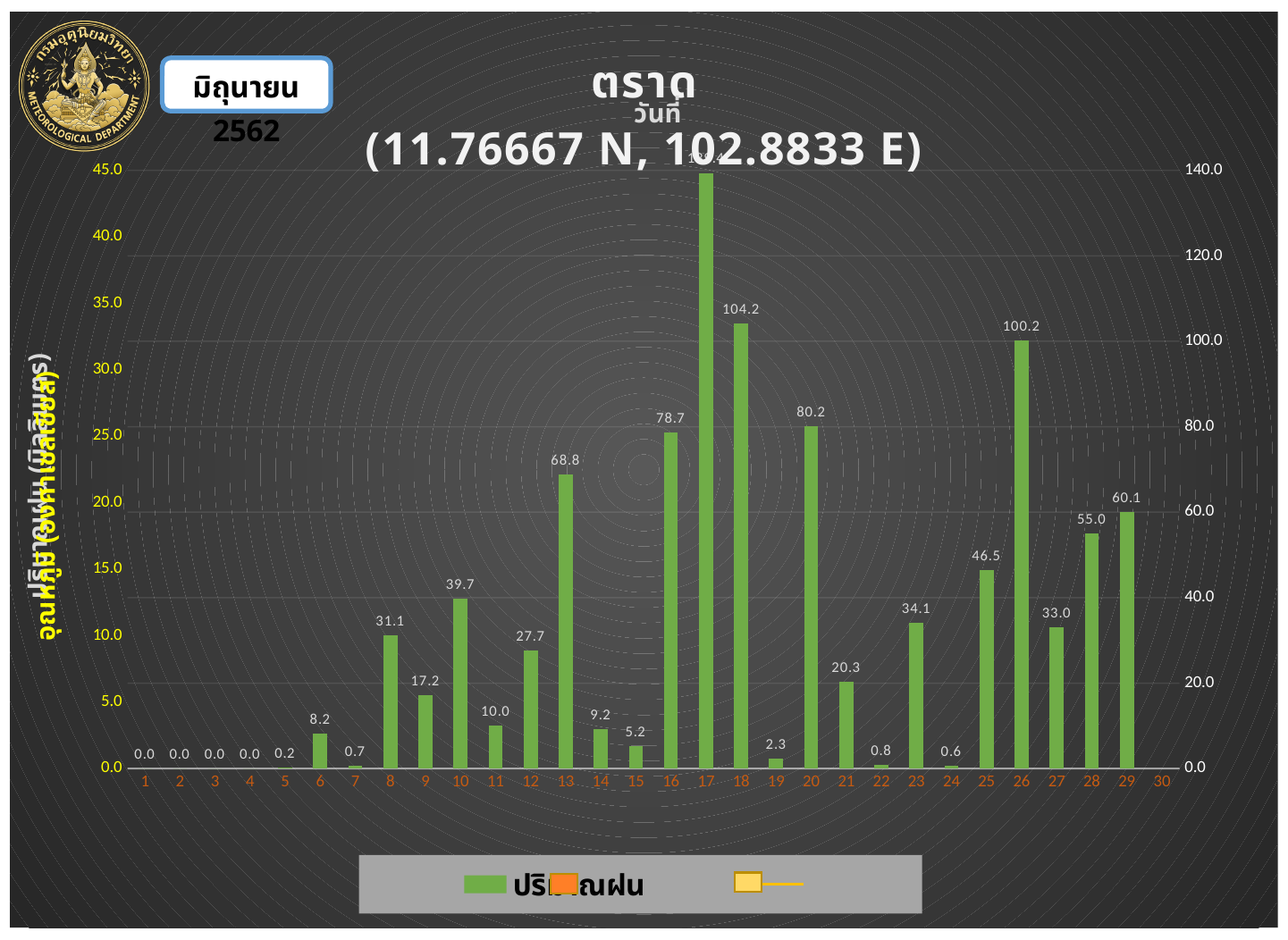
On the right-hand axis, is the value for day 17 greater or less than 120.0? greater What is the value shown for day 29? 60.1 Which is larger, the value for day 16 or the value for day 20? day 20 What is the value shown for day 18? 104.2 What kind of chart is shown on the slide? bar chart Which day has the tallest bar? 17 What is the value shown for day 10? 39.7 What is the value shown for day 26? 100.2 What is the difference between the values for day 18 and day 26? 4.0 How many days are labelled along the x axis? 30 What is the difference between the values for day 29 and day 28? 5.1 What is the main title of the chart? ตราด